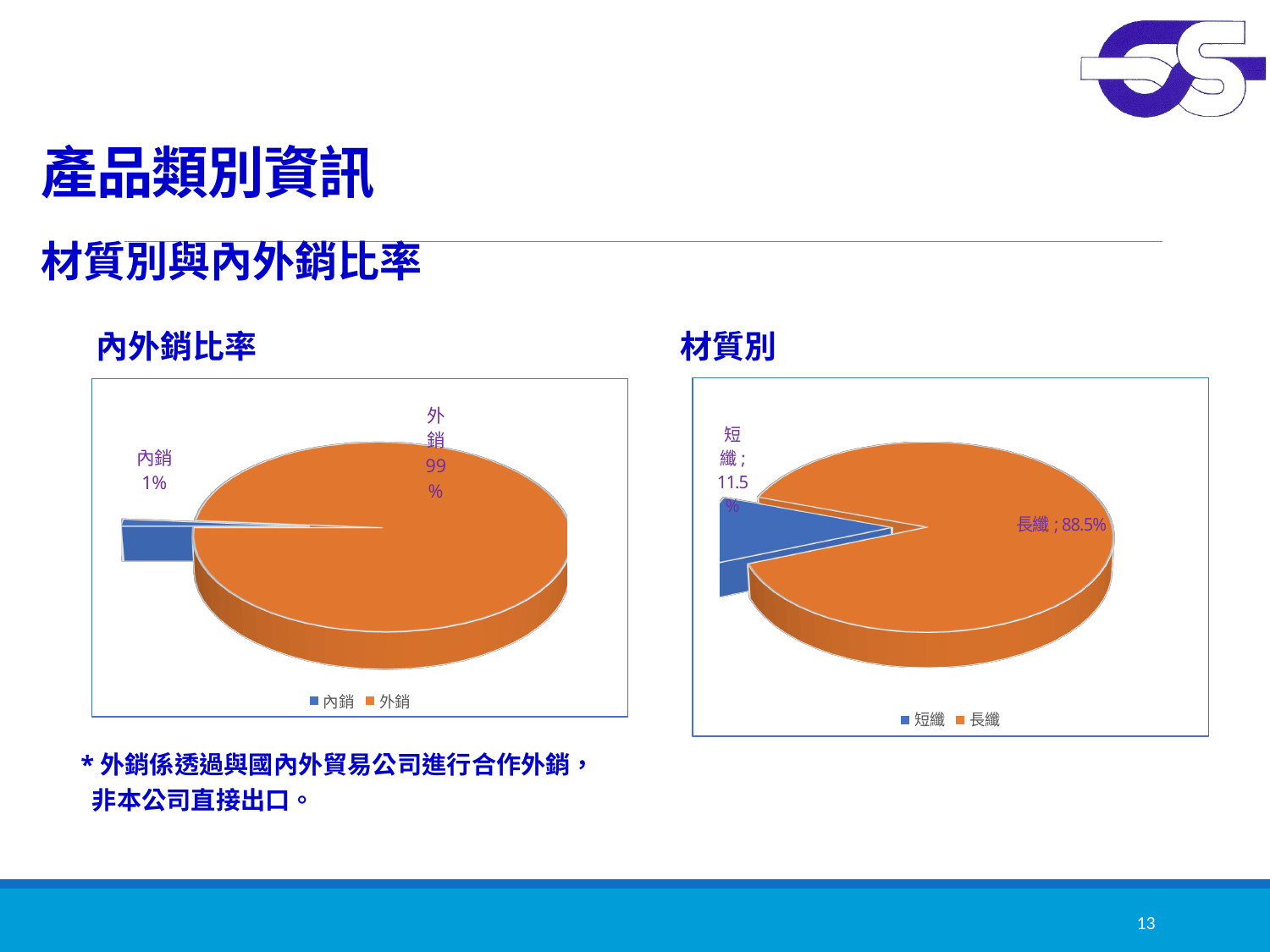
In the 內外銷比率 chart, what is the value for 內銷? 1% In the 材質別 chart, what is the value for 短纖? 11.5% In the 材質別 chart, what is the value for 長纖? 88.5% How many entries does the legend of the 材質別 chart list? 2 In the 內外銷比率 chart, what is the value for 外銷? 99% In the 材質別 chart, what is the difference between the 長纖 and 短纖 shares? 77% What kind of chart is the 材質別 chart? Pie chart How many categories does the 內外銷比率 chart show? 2 In the 材質別 chart, which category has the largest share? 長纖 In the 內外銷比率 chart, which is larger, 內銷 or 外銷? 外銷 In the 內外銷比率 chart, which category has the smallest share? 內銷 In the 材質別 chart, what colour is the 短纖 slice? Blue